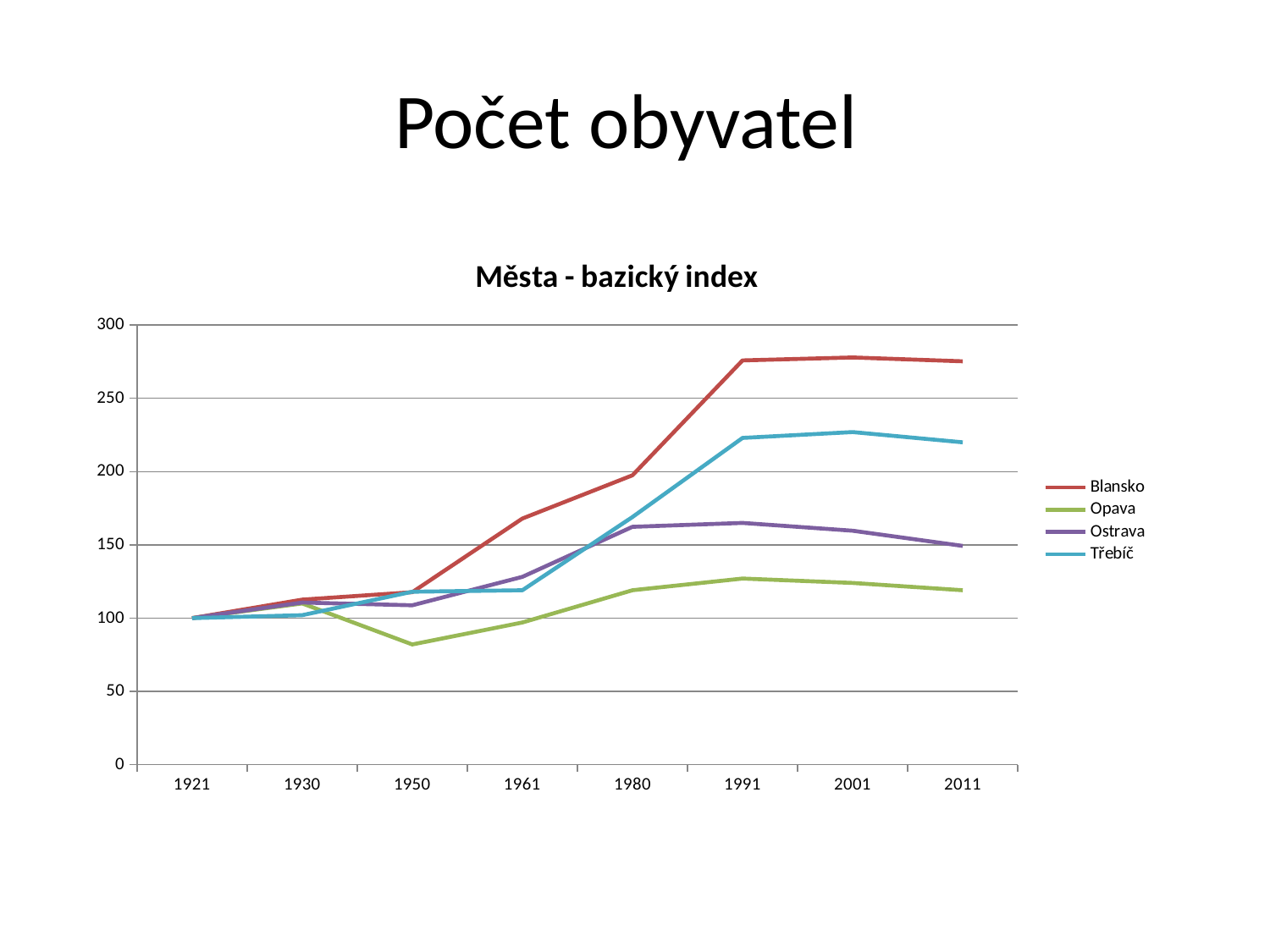
How many series does the legend list? 4 What kind of chart is shown on the slide? line chart In 2001, which is larger, the value for Třebíč or the value for Ostrava? Třebíč What is the value for Blansko in 1921? 100 How many years are shown on the x axis? 8 Is the value for Třebíč in 1991 greater or less than 200? greater Which city has the highest value in 2011? Blansko Which city has the lowest value in 2011? Opava Is the value for Opava in 1950 greater or less than 100? less Does the Blansko line rise or fall from 1921 to 1991? rise What is the chart's title? Města - bazický index Is the value for Blansko in 2001 greater or less than 250? greater